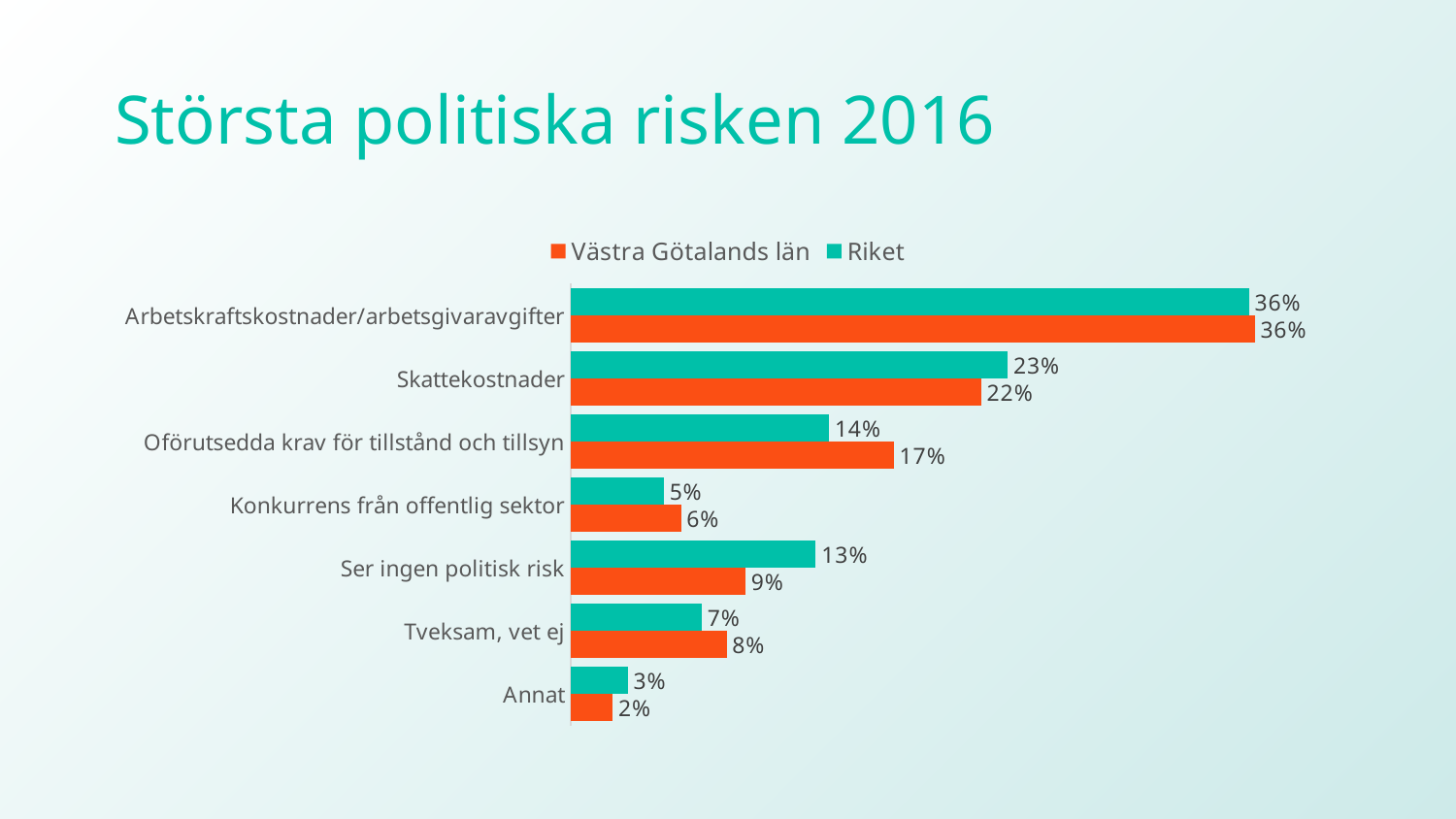
How many series does the legend list? 2 What kind of chart is shown on the slide? Bar chart How many categories are shown in the chart? 7 What is the value for Västra Götalands län for Oförutsedda krav för tillstånd och tillsyn? 17% Which colour represents Riket in the chart? Teal Which category has the highest value for Västra Götalands län? Arbetskraftskostnader/arbetsgivaravgifter What is the title of the slide? Största politiska risken 2016 Which is larger for Oförutsedda krav för tillstånd och tillsyn: Västra Götalands län or Riket? Västra Götalands län What is the value for Riket for Ser ingen politisk risk? 13% What is the difference between Riket and Västra Götalands län for Ser ingen politisk risk? 4% What is the value for Riket for Skattekostnader? 23% Which category has the lowest value for Riket? Annat